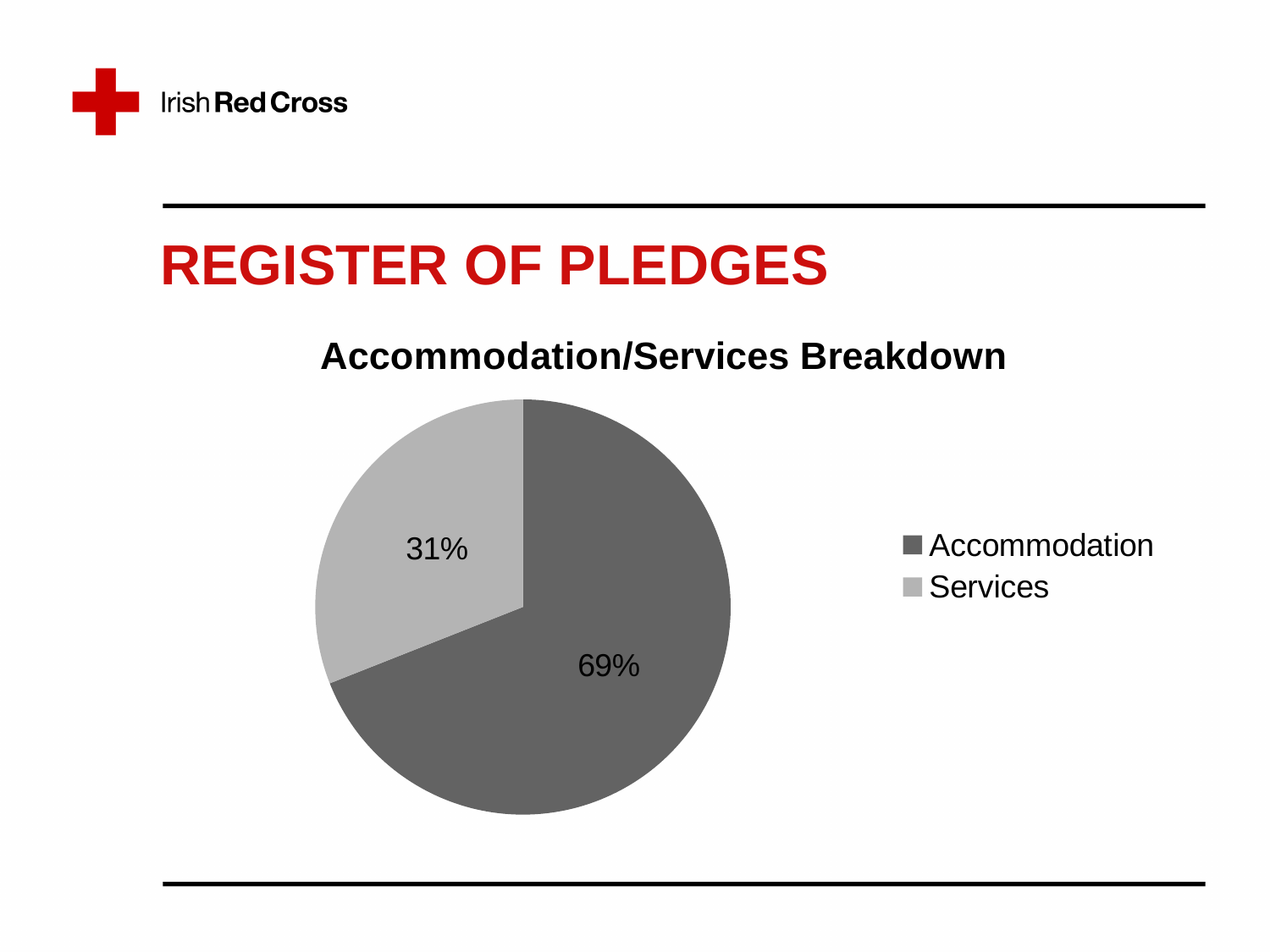
What share of the pie does Accommodation represent? 69% Which category has the largest slice of the pie? Accommodation What is the difference in percentage points between the Accommodation and Services slices? 38 Which category is shown in the lighter grey colour? Services Which is larger, the Accommodation slice or the Services slice? Accommodation What kind of chart is shown on the slide? Pie chart Which category has the smallest slice of the pie? Services How many slices does the pie chart have? 2 Is the share for Services greater or less than 50%? less What share of the pie does Services represent? 31% What is the title of the chart? Accommodation/Services Breakdown